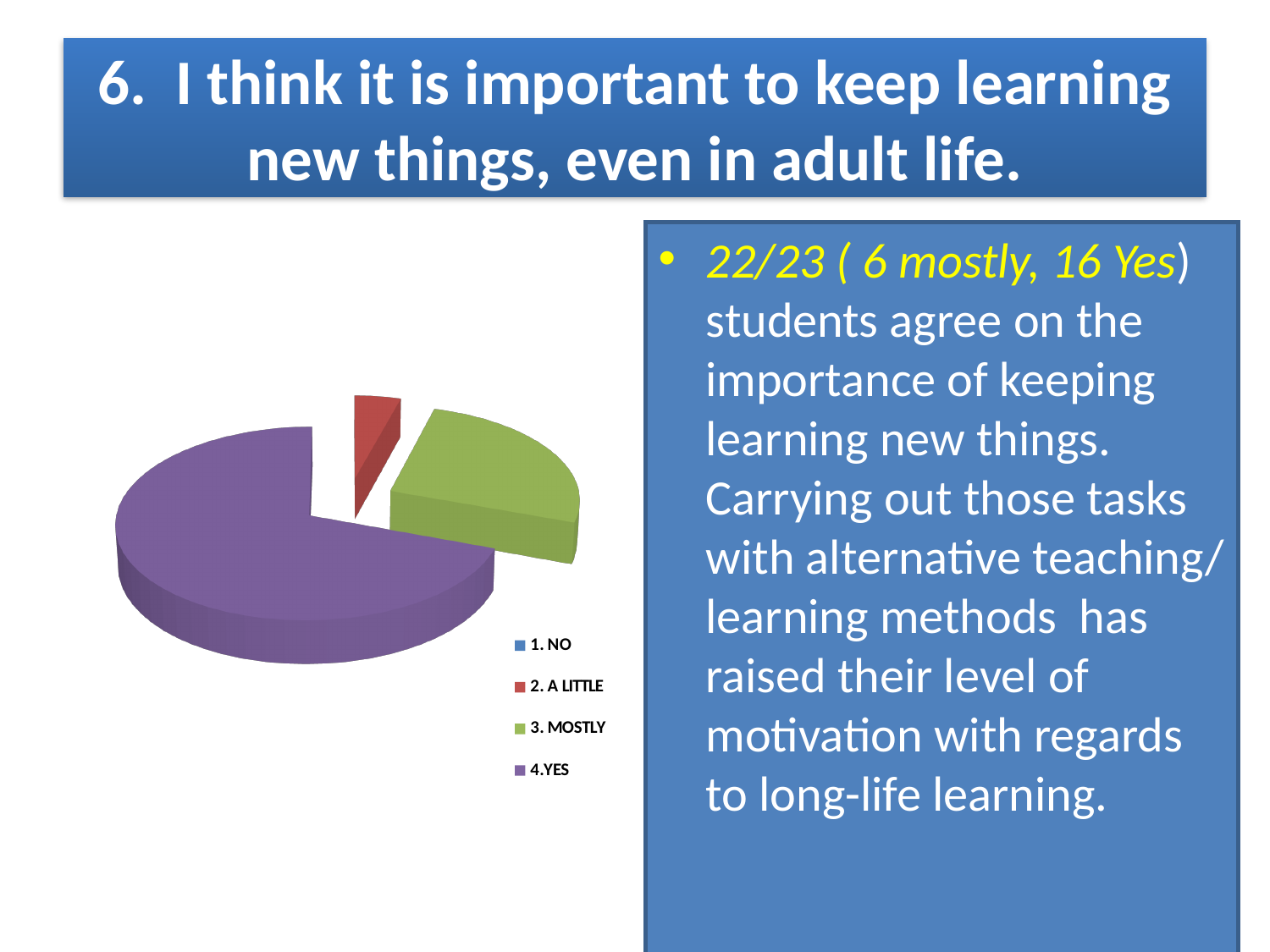
According to the slide, how many students answered Mostly? 6 Does the 4.YES slice take up more or less than half of the pie? more What colour is the 3. MOSTLY slice of the pie? green What colour is the 4.YES slice of the pie? purple Which slice is larger, 4.YES or 3. MOSTLY? 4.YES Which slice is larger, 3. MOSTLY or 2. A LITTLE? 3. MOSTLY What kind of chart is shown on the slide? pie chart How many entries does the chart's legend list? 4 Which category takes up the largest slice of the pie? 4.YES According to the slide, how many students answered Yes? 16 How many more students answered Yes than Mostly, according to the slide? 10